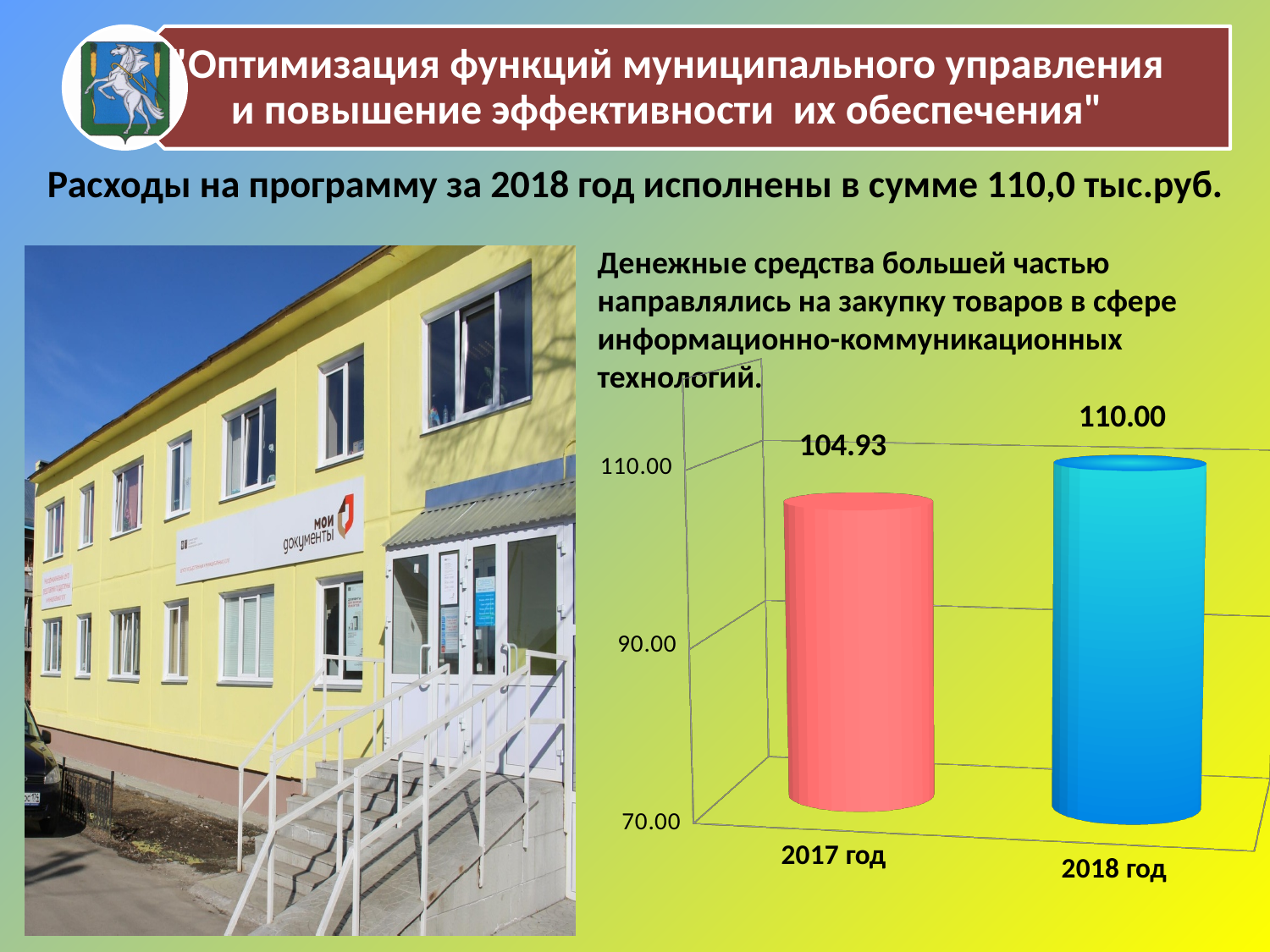
What kind of chart is shown on the slide? bar chart What colour is the bar for 2018 год? blue What is the value for 2017 год? 104.93 Which year has the higher value? 2018 год Which year has the lower value? 2017 год Is the value for 2018 год larger or smaller than the value for 2017 год? larger What is the difference between the values for 2018 год and 2017 год? 5.07 What colour is the bar for 2017 год? red How many categories are shown on the x axis? 2 What is the value for 2018 год? 110.00 Do the values rise or fall from 2017 год to 2018 год? rise Is the value for 2017 год greater or less than 90.00? greater